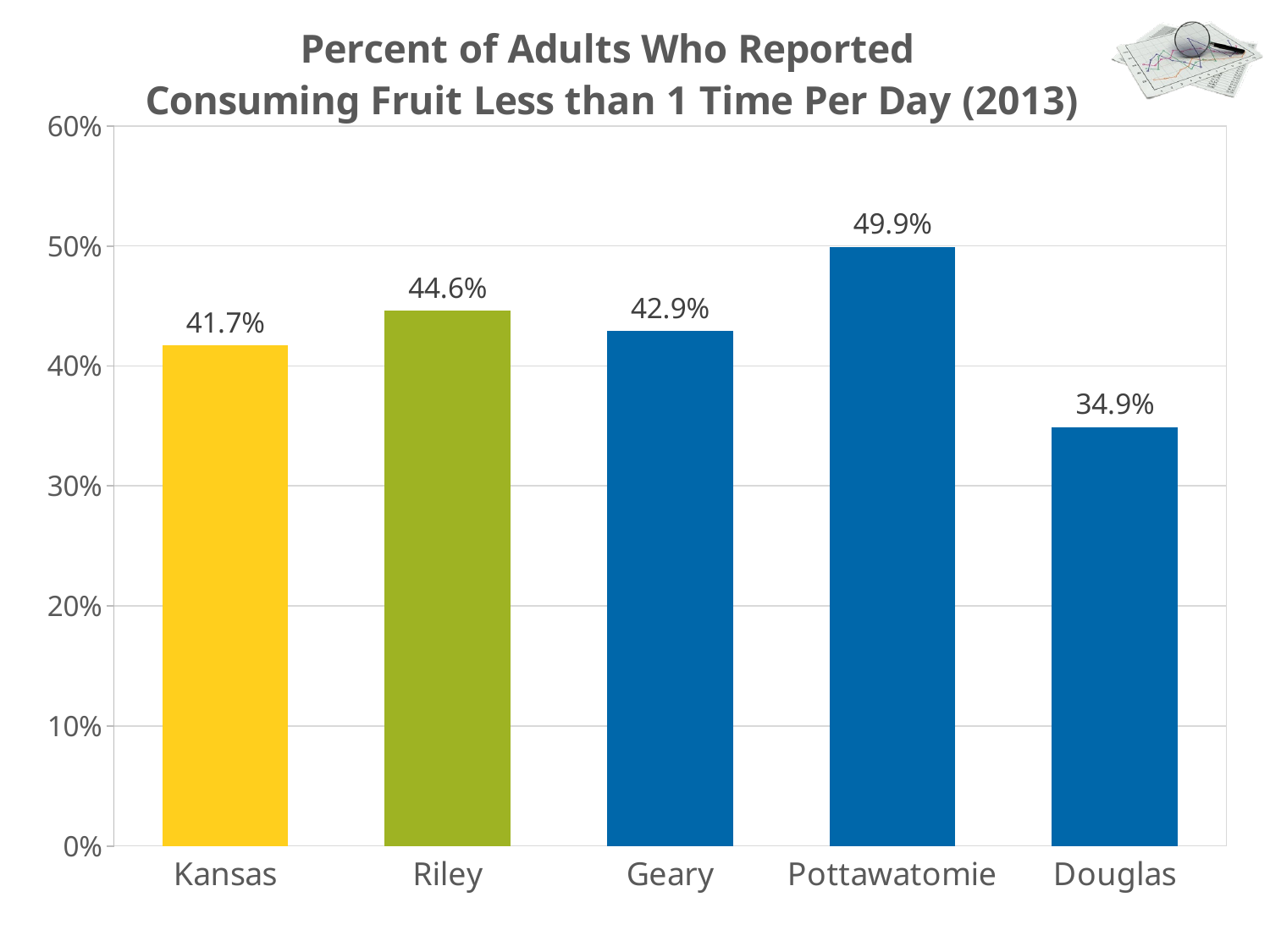
What is the value for Pottawatomie? 49.9% How many categories are shown on the x axis? 5 What is the value for Kansas? 41.7% What is the title of the chart? Percent of Adults Who Reported Consuming Fruit Less than 1 Time Per Day (2013) What is the value for Douglas? 34.9% What is the difference between the values for Pottawatomie and Douglas? 15.0% What kind of chart is shown on the slide? bar chart Which category has the highest value? Pottawatomie Which is larger, the value for Riley or the value for Geary? Riley Is the value for Douglas greater or less than 40%? less Which category has the lowest value? Douglas What is the difference between the values for Riley and Kansas? 2.9%